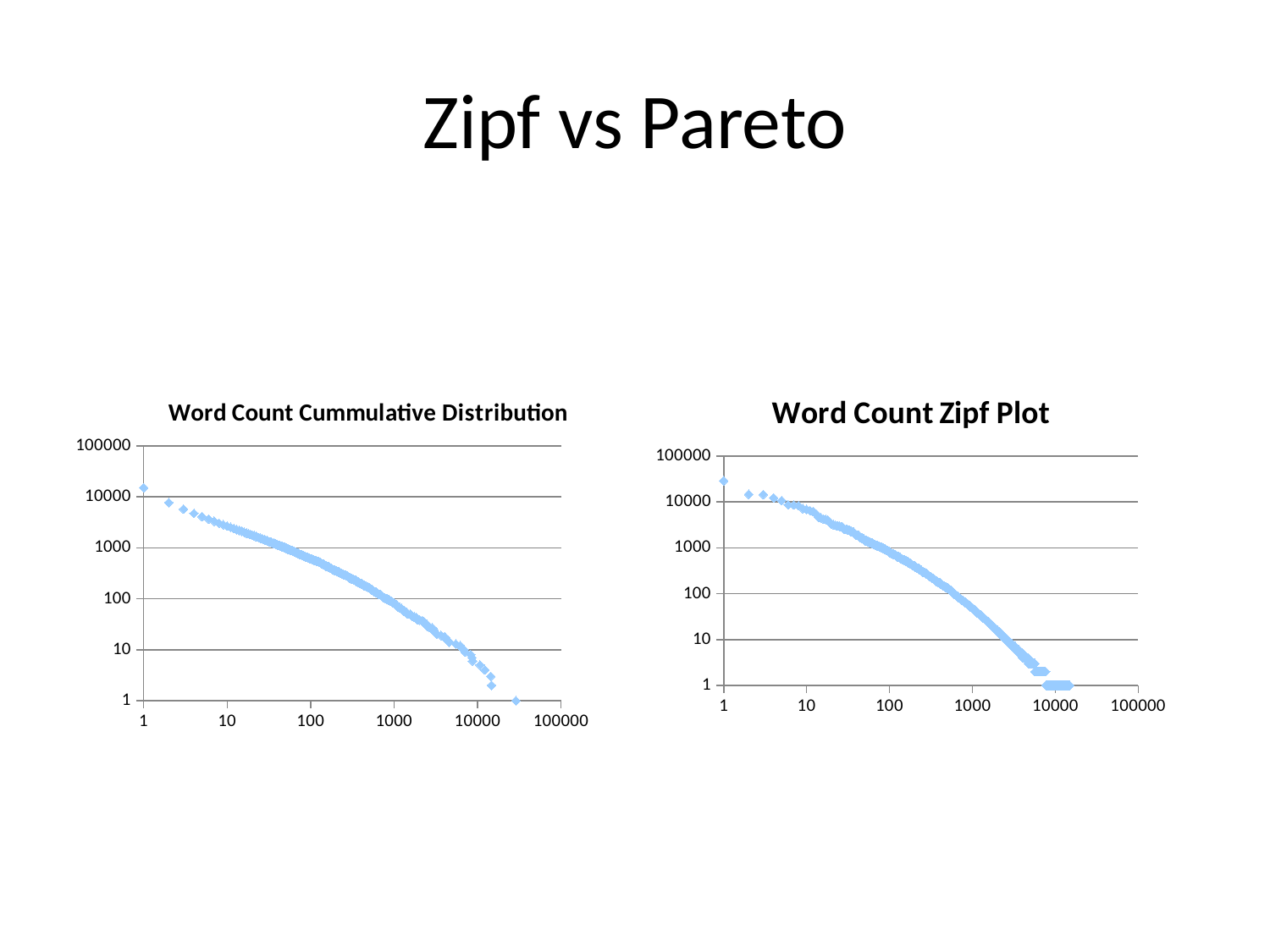
In the "Word Count Cummulative Distribution" chart, is the value of the first point at x = 1 greater or less than 10000? greater What is the highest tick label shown on the y axis of the "Word Count Zipf Plot" chart? 100000 In the "Word Count Zipf Plot" chart, is the value at x = 10 greater or less than 1000? greater In the "Word Count Cummulative Distribution" chart, do the plotted values rise or fall as the x axis increases? fall In the "Word Count Zipf Plot" chart, is the value of the first point at x = 1 greater or less than 10000? greater What kind of chart is the "Word Count Zipf Plot" chart on the right? scatter plot What kind of chart is the "Word Count Cummulative Distribution" chart on the left? scatter plot What is the title of the chart on the left of the slide? Word Count Cummulative Distribution In the "Word Count Zipf Plot" chart, do the plotted values rise or fall as the x axis increases? fall